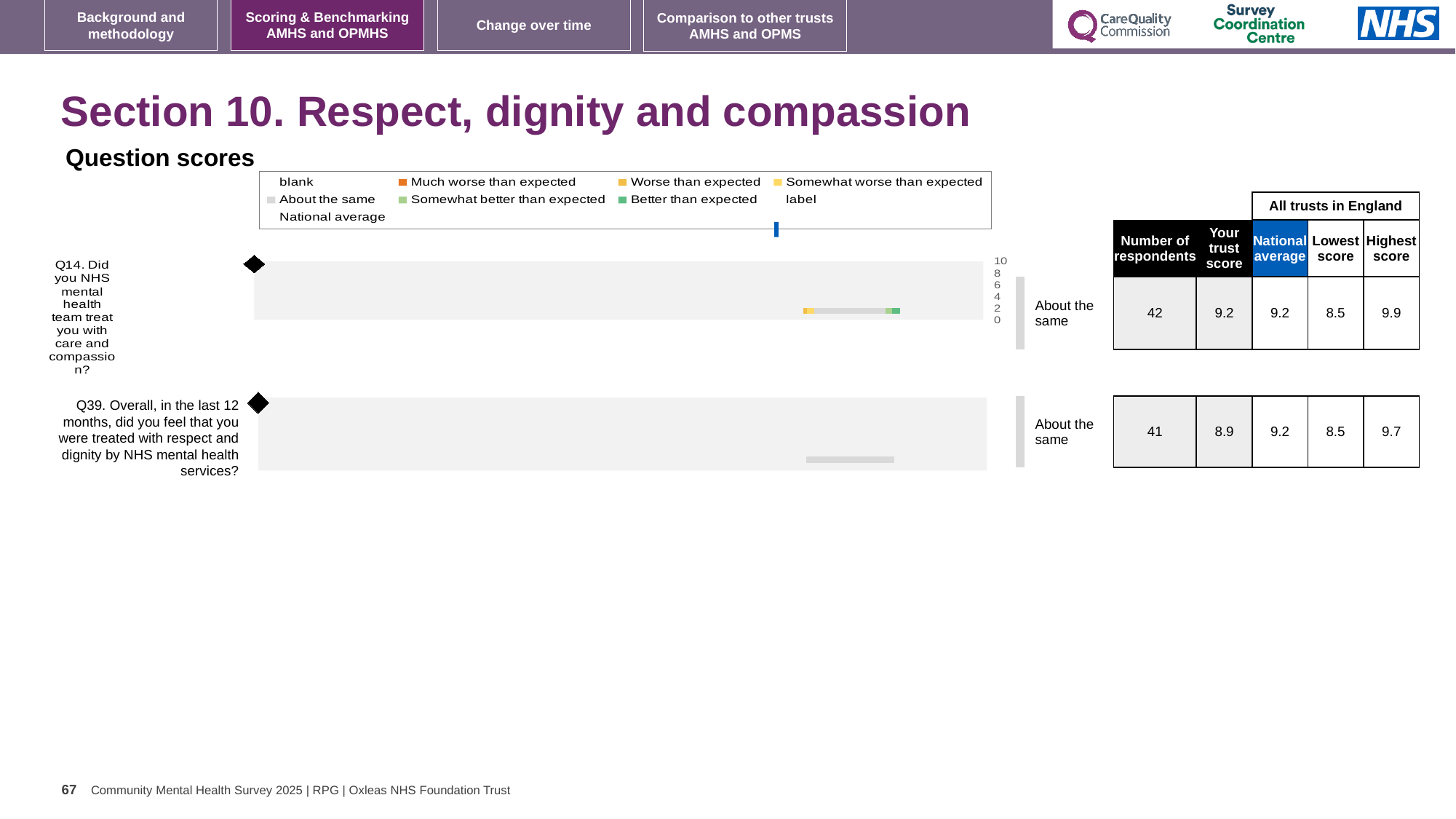
What kind of chart is shown under 'Question scores'? bar chart Which question has the higher trust score, Q14 or Q39? Q14 How many questions (categories) are plotted in the Question scores chart? 2 What is the lowest score across all trusts in England for Q39? 8.5 What is the highest value shown on the chart's axis? 10 What is the number of respondents for Q14? 42 What benchmark label is given for Q14 (care and compassion)? About the same Which legend entry is marked in orange? Much worse than expected What benchmark label is given for Q39 (respect and dignity)? About the same What is the national average for Q14? 9.2 What is the difference between the highest score for Q14 (9.9) and the highest score for Q39 (9.7)? 0.2 What is the trust score for Q39? 8.9